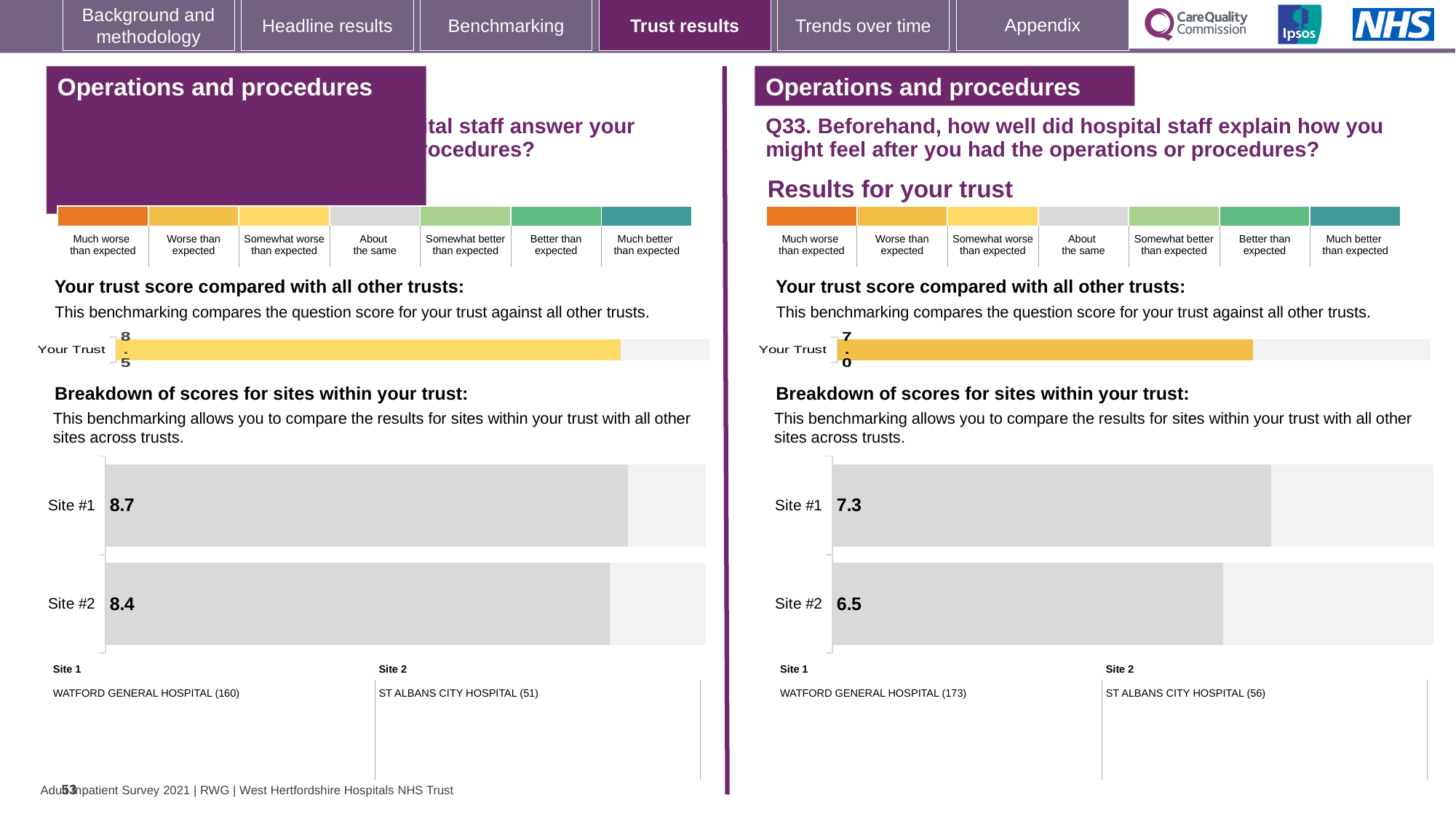
In the Q33 site breakdown chart on the right half of the slide, what is the difference between the Site #1 and Site #2 scores? 0.8 On the left half of the slide, what is the score shown for Site #2 in the breakdown of scores for sites within your trust? 8.4 In the Q33 chart on the right half of the slide, what is the 'Your Trust' score in the trust score comparison chart? 7.0 In the Q33 chart on the right half of the slide, what is the score shown for Site #1? 7.3 In the Q33 site breakdown chart on the right half of the slide, which site has the higher score? Site #1 What type of chart is used for the site breakdown on the right half of the slide? Bar chart On the left half of the slide, what is the score shown for Site #1 in the breakdown of scores for sites within your trust? 8.7 On the left half of the slide, what is the 'Your Trust' score in the trust score comparison chart? 8.5 How many sites are shown in the Q33 site breakdown chart on the right half of the slide? 2 On the left half of the slide, which site has the lower score in the site breakdown chart? Site #2 On the left half of the slide, what is the difference between the Site #1 and Site #2 scores in the site breakdown chart? 0.3 In the Q33 chart on the right half of the slide, what is the score shown for Site #2? 6.5